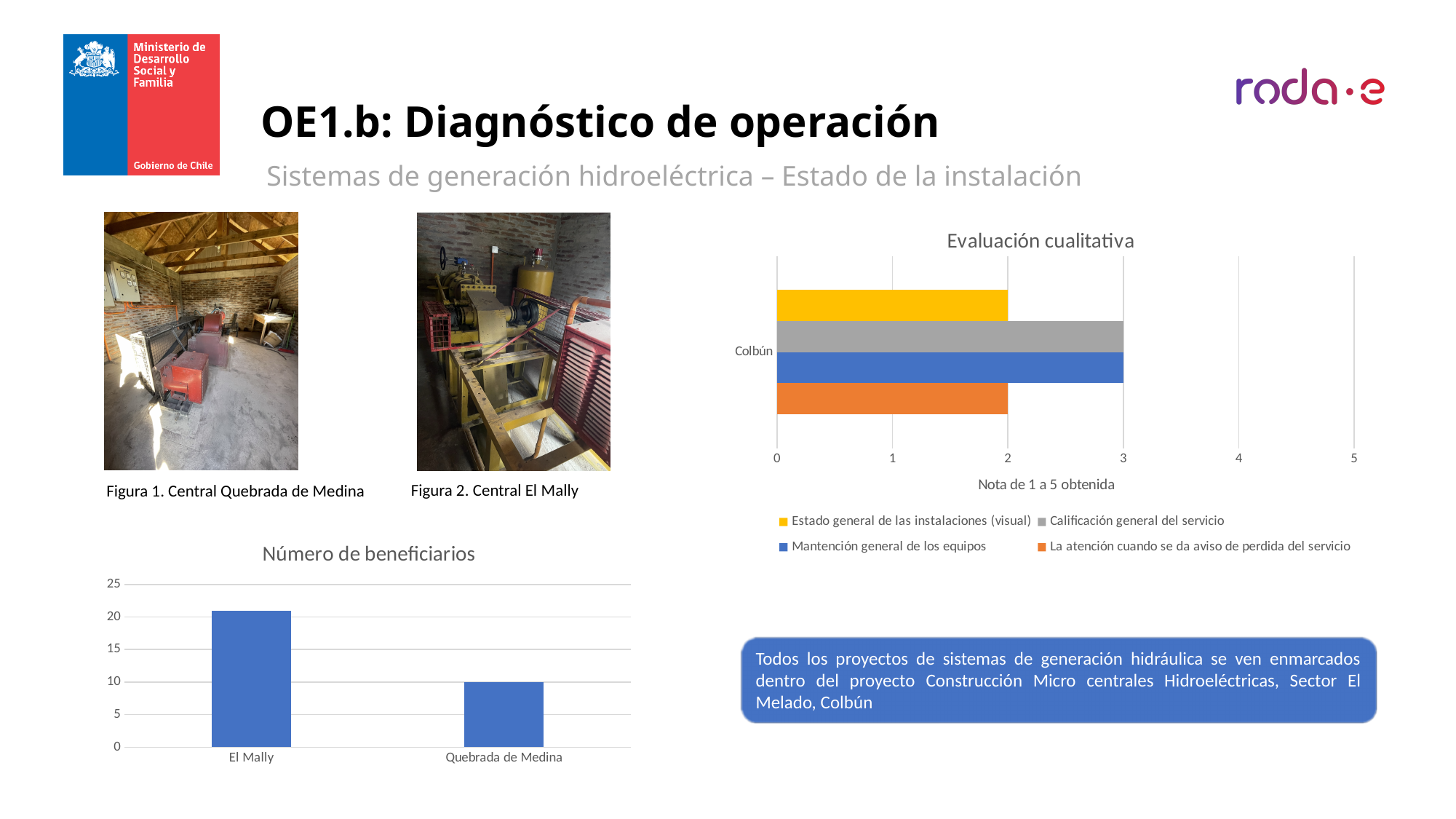
In the 'Evaluación cualitativa' chart, which is larger for Colbún: 'Calificación general del servicio' or 'Estado general de las instalaciones (visual)'? Calificación general del servicio In the 'Evaluación cualitativa' chart, what score does Colbún get for 'Calificación general del servicio'? 3 In the 'Evaluación cualitativa' chart, how many series does the legend list? 4 In the 'Evaluación cualitativa' chart, what score does Colbún get for 'La atención cuando se da aviso de perdida del servicio'? 2 In the 'Número de beneficiarios' chart, how many beneficiaries does Quebrada de Medina have? 10 What kind of chart is 'Número de beneficiarios'? Bar chart In the 'Evaluación cualitativa' chart, what is the label on the horizontal axis? Nota de 1 a 5 obtenida In the 'Evaluación cualitativa' chart, what score does Colbún get for 'Estado general de las instalaciones (visual)'? 2 In the 'Evaluación cualitativa' chart, what is the difference between the 'Mantención general de los equipos' score and the 'La atención cuando se da aviso de perdida del servicio' score? 1 In the 'Evaluación cualitativa' chart, what score does Colbún get for 'Mantención general de los equipos'? 3 In the 'Número de beneficiarios' chart, which category has the highest value? El Mally In the 'Número de beneficiarios' chart, is the value for El Mally greater or less than 20? greater